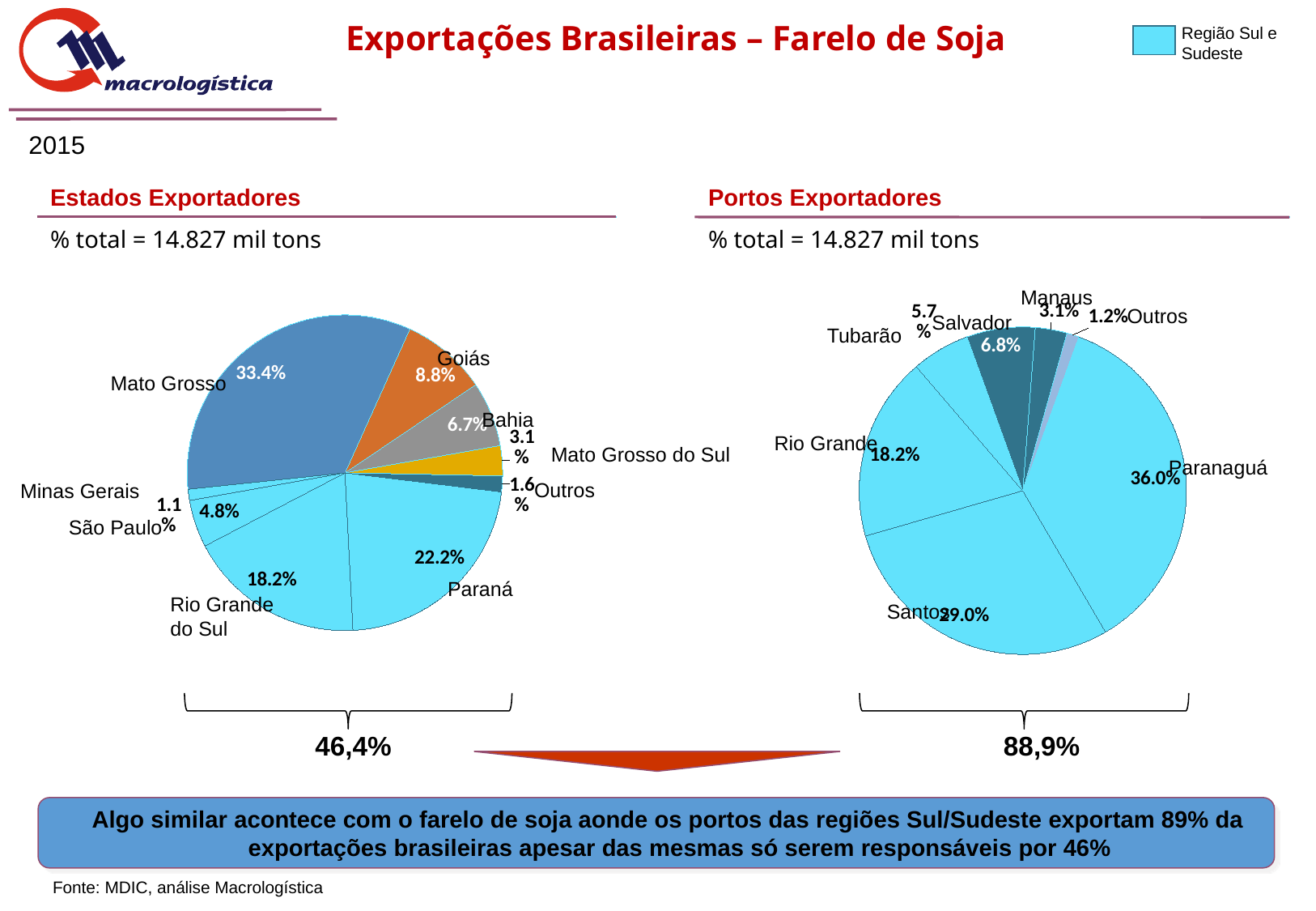
In the Portos Exportadores pie chart, which port has the largest share? Paranaguá How many slices does the Estados Exportadores pie chart have? 9 In the Estados Exportadores pie chart, what is the difference between the shares of Mato Grosso and Paraná? 11.2% In the Estados Exportadores pie chart, which category has the smallest share? Minas Gerais In the Portos Exportadores pie chart, what share does Santos have? 29.0% How many slices does the Portos Exportadores pie chart have? 7 In the Estados Exportadores pie chart, which is larger, Goiás or Bahia? Goiás In the Estados Exportadores pie chart, what share does Paraná have? 22.2% In the Estados Exportadores pie chart, which state has the largest share? Mato Grosso In the Estados Exportadores pie chart, what share does Mato Grosso have? 33.4% What type of chart is used for Portos Exportadores? Pie chart In the Portos Exportadores pie chart, what share does Paranaguá have? 36.0%